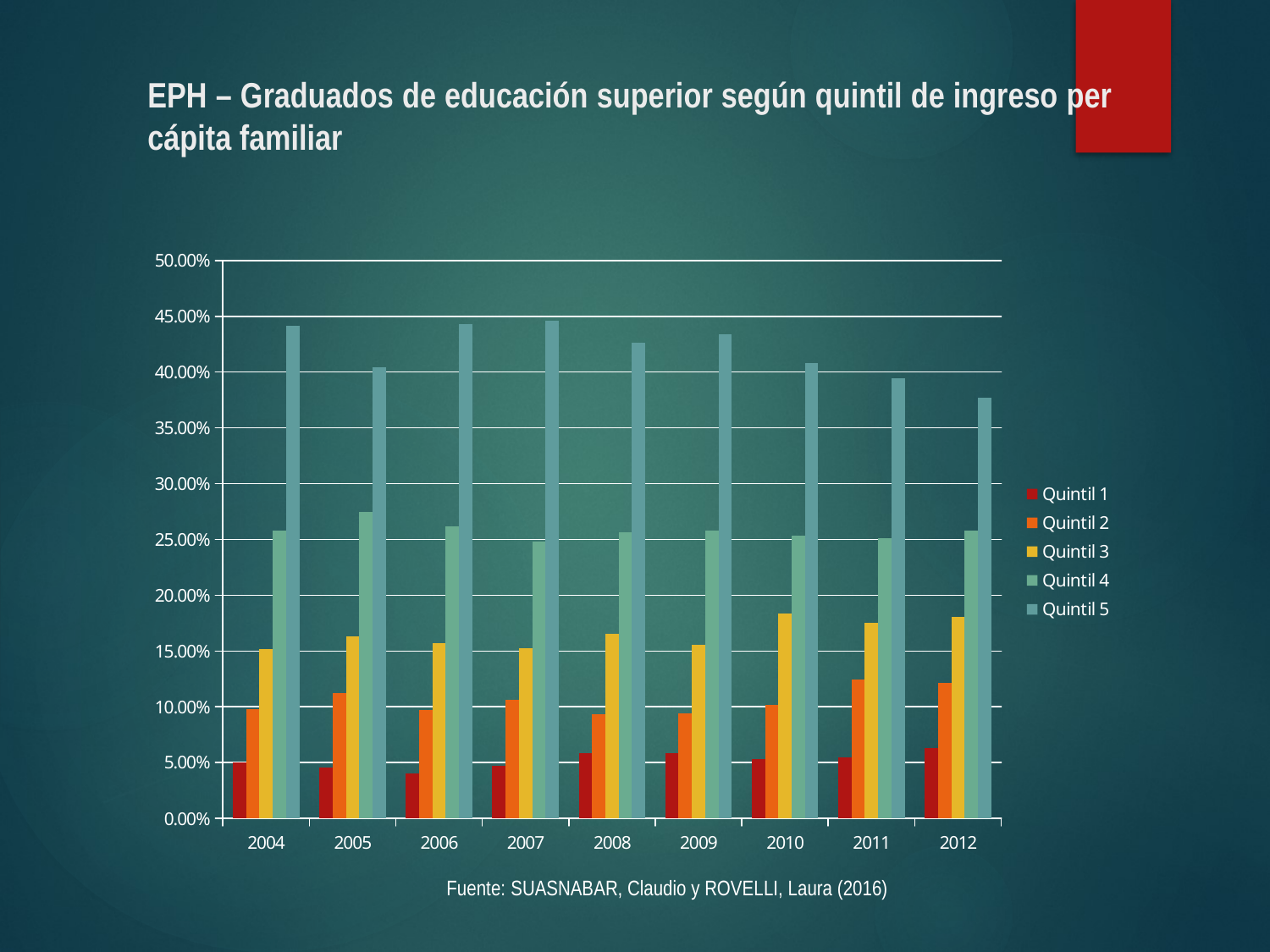
Is the value for Quintil 4 in 2005 greater or less than 25.00%? greater What kind of chart is shown on the slide? bar chart Is the value for Quintil 1 in 2006 greater or less than 5.00%? less In which year is the value for Quintil 5 the lowest? 2012 Is the value for Quintil 5 in 2004 greater or less than 40.00%? greater How many series does the legend list? 5 Which is larger: the value for Quintil 3 in 2010 or in 2004? 2010 How many years are shown on the x axis? 9 Which quintile has the highest value in 2004? Quintil 5 Does the value for Quintil 5 rise or fall from 2009 to 2012? fall Which quintile has the lowest value in 2012? Quintil 1